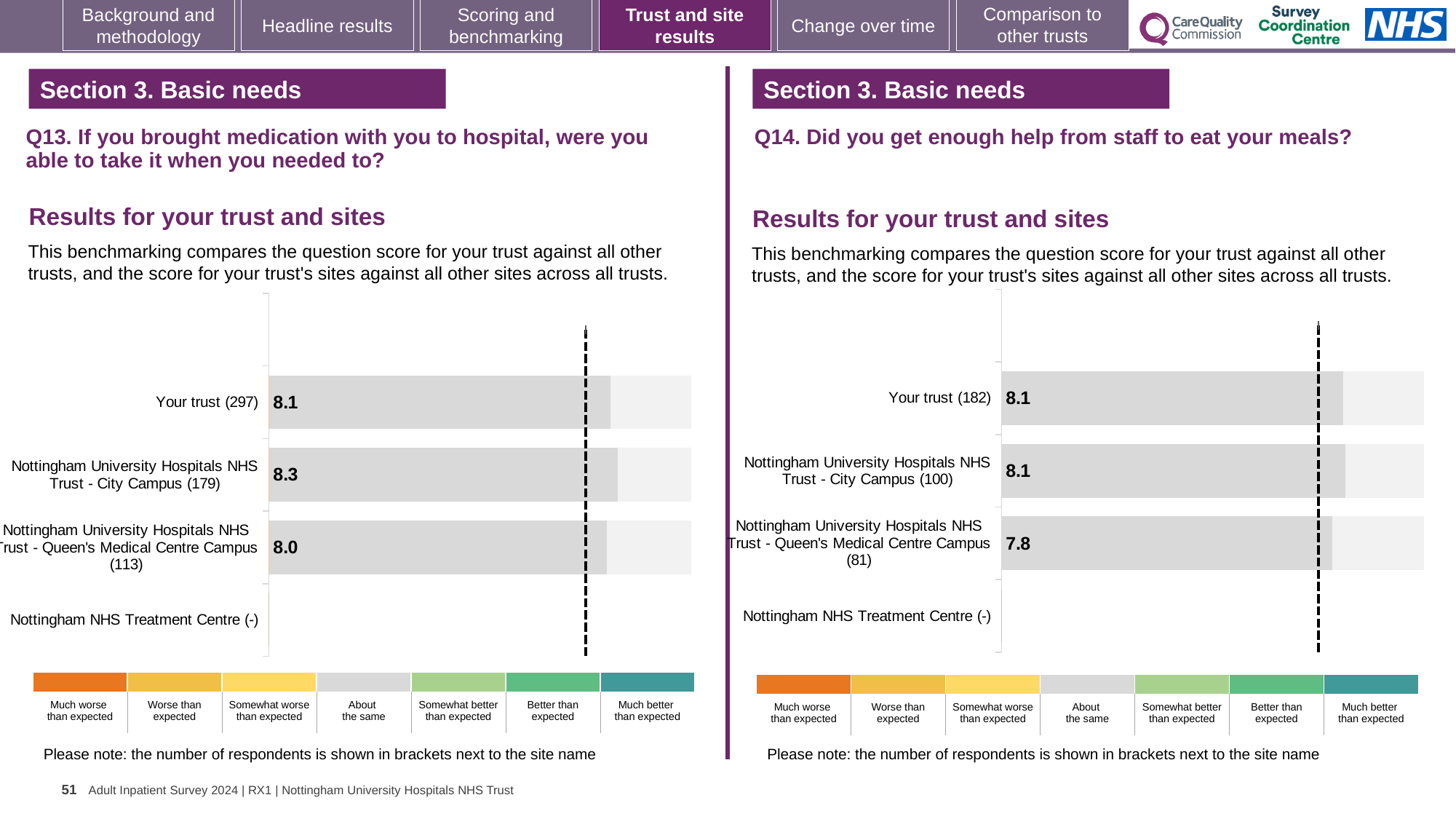
In the Q14 chart on the right, is the score for Your trust (182) larger or smaller than the score for City Campus (100)? They are the same (8.1) In the Q14 chart on the right, what is the score for Your trust (182)? 8.1 In the Q13 chart on the left, what is the score for Your trust (297)? 8.1 In the Q13 chart on the left, what is the difference between the City Campus score and the Queen's Medical Centre Campus score? 0.3 In the Q13 chart on the left, what is the score for Nottingham University Hospitals NHS Trust - Queen's Medical Centre Campus (113)? 8.0 In the Q14 chart on the right, which site or trust has the lowest score among those with a value shown? Nottingham University Hospitals NHS Trust - Queen's Medical Centre Campus (81) How many rows (sites or trust) are listed on the y axis of the Q13 chart on the left? 4 In the Q13 chart on the left, which site or trust has the highest score? Nottingham University Hospitals NHS Trust - City Campus (179) In the Q14 chart on the right, what is the difference between the Your trust score and the Queen's Medical Centre Campus score? 0.3 What kind of chart is used for the Q14 results on the right? Bar chart In the Q14 chart on the right, what is the score for Nottingham University Hospitals NHS Trust - Queen's Medical Centre Campus (81)? 7.8 In the Q13 chart on the left, what is the score for Nottingham University Hospitals NHS Trust - City Campus (179)? 8.3